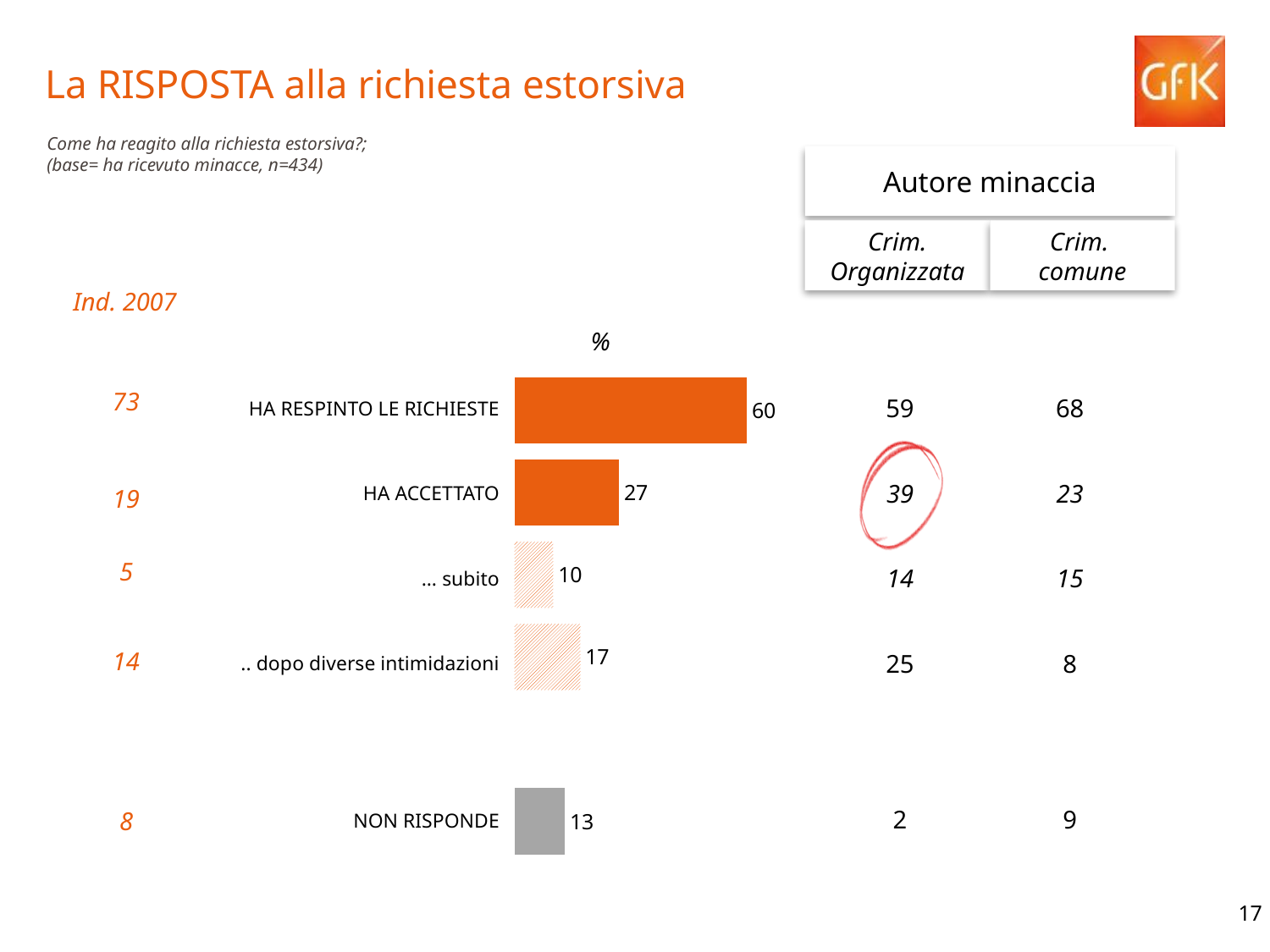
What is the value shown for HA RESPINTO LE RICHIESTE in the bar chart? 60 What is the Ind. 2007 value shown next to HA RESPINTO LE RICHIESTE? 73 What kind of chart is shown on the slide? Bar chart Which category has the lowest value in the bar chart? ... subito What is the value shown for '.. dopo diverse intimidazioni' in the bar chart? 17 What is the Crim. Organizzata value shown for HA ACCETTATO? 39 How many bars are shown in the bar chart? 5 Which category has the highest value in the bar chart? HA RESPINTO LE RICHIESTE Which is larger in the bar chart: the value for '.. dopo diverse intimidazioni' or the value for NON RISPONDE? .. dopo diverse intimidazioni What is the value shown for HA ACCETTATO in the bar chart? 27 What is the difference between the values for HA RESPINTO LE RICHIESTE and HA ACCETTATO in the bar chart? 33 What is the value shown for NON RISPONDE in the bar chart? 13